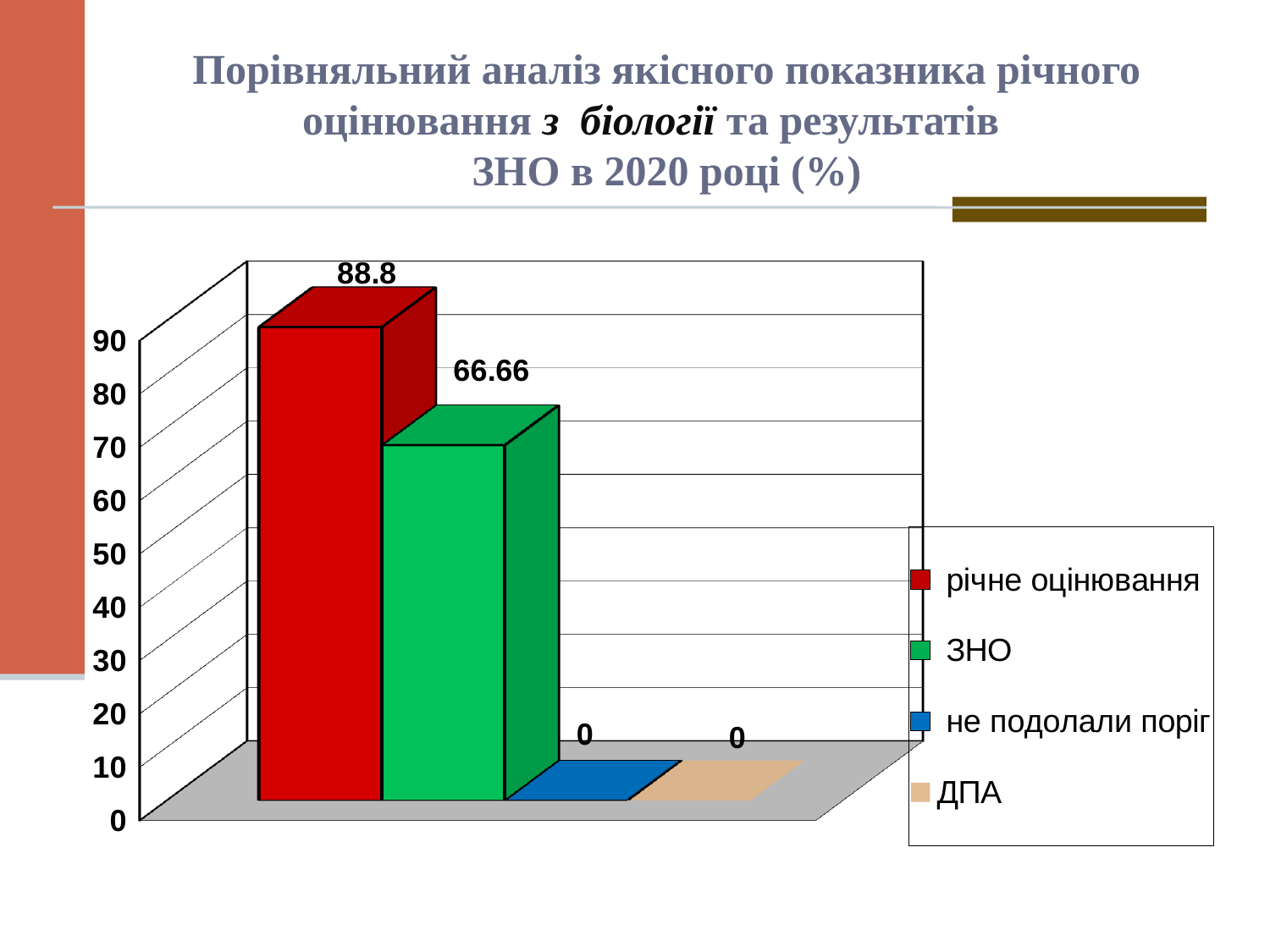
What kind of chart is shown on the slide? bar chart How many series does the legend list? 4 What is the value for ЗНО? 66.66 Which is larger, the value for річне оцінювання or the value for ЗНО? річне оцінювання What colour is the bar for ЗНО? green Which series has the highest value? річне оцінювання What is the value for ДПА? 0 What is the difference between the values for річне оцінювання and ЗНО? 22.14 What is the value for не подолали поріг? 0 Is the value for ЗНО greater or less than 60? greater What is the highest value shown on the vertical axis? 90 What is the value for річне оцінювання? 88.8